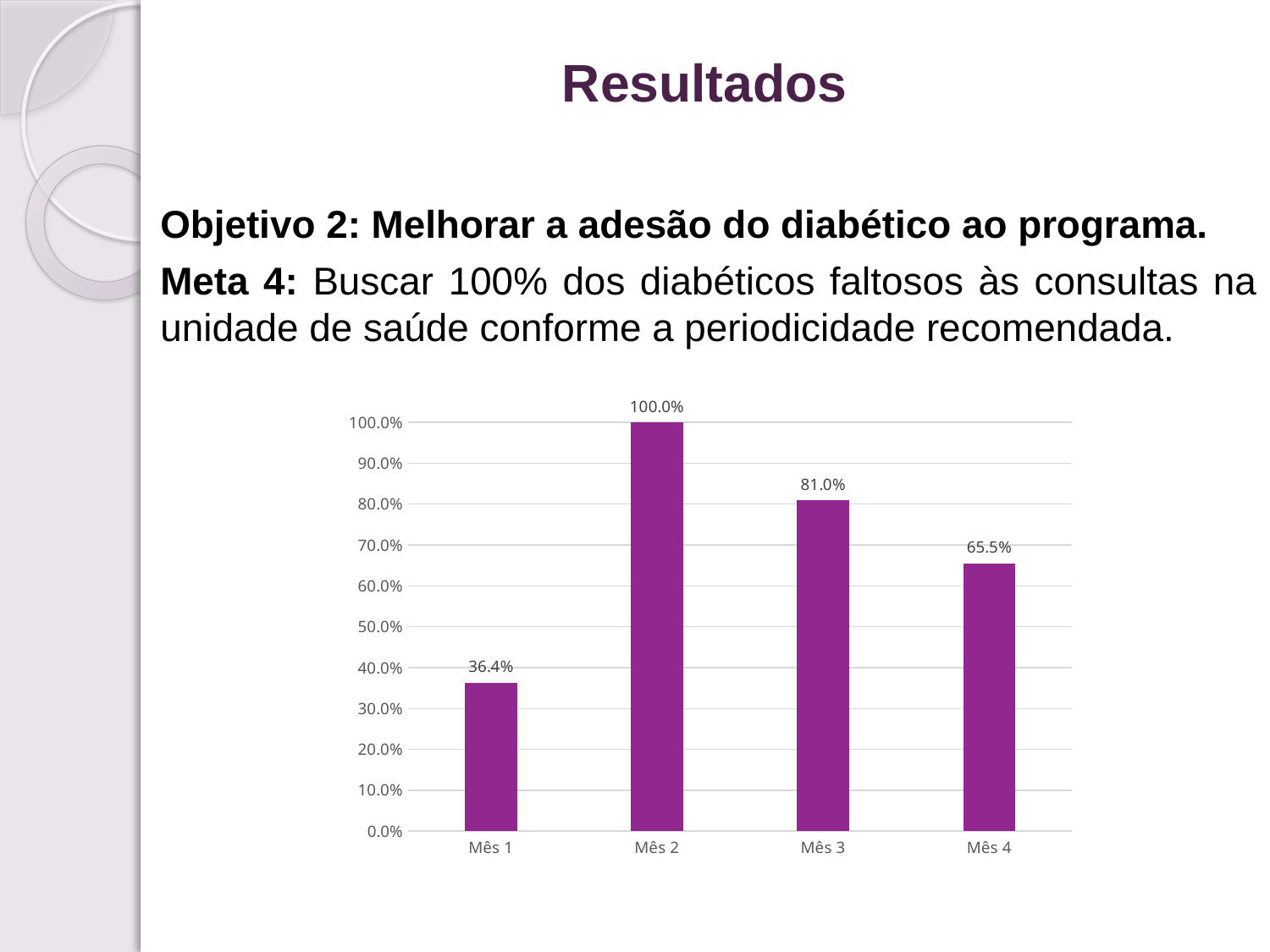
What kind of chart is shown on the slide? bar chart What is the difference between the values for Mês 3 and Mês 4? 15.5% What is the difference between the values for Mês 2 and Mês 1? 63.6% What is the value for Mês 1? 36.4% What is the value for Mês 3? 81.0% Which month has the lowest value? Mês 1 Which month has the highest value? Mês 2 Which is larger, the value for Mês 3 or the value for Mês 4? Mês 3 How many months are shown on the x axis? 4 What is the value for Mês 2? 100.0% What is the value for Mês 4? 65.5% Is the value for Mês 1 greater or less than 40.0%? less